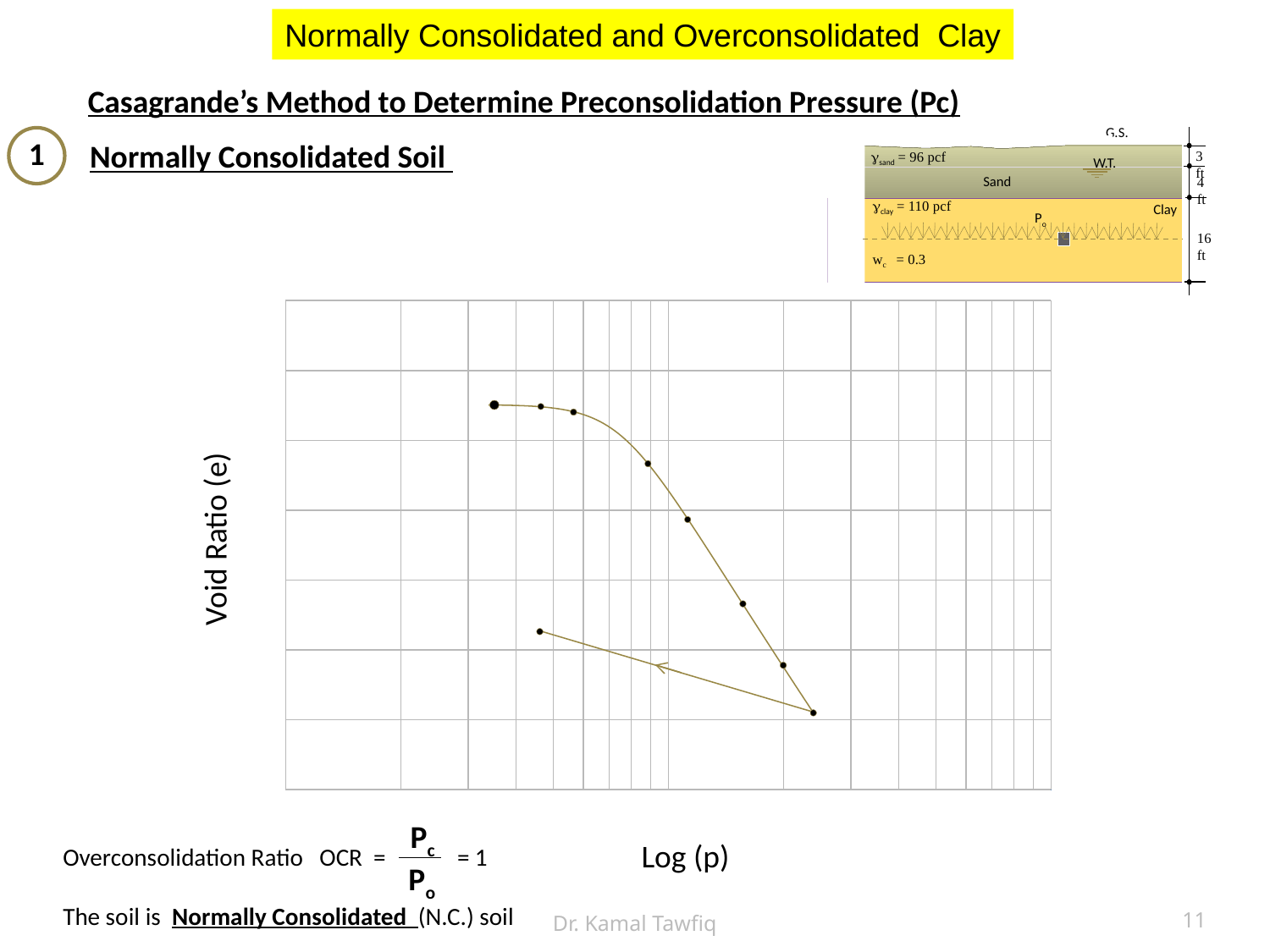
What is the label of the horizontal axis of the chart? Log (p) What kind of chart is shown on the slide? line chart Along the lower straight line with the arrow, does the void ratio rise or fall as Log (p) increases? fall Along the main curve, does the void ratio rise or fall as Log (p) increases? fall What is the label of the vertical axis of the chart? Void Ratio (e)